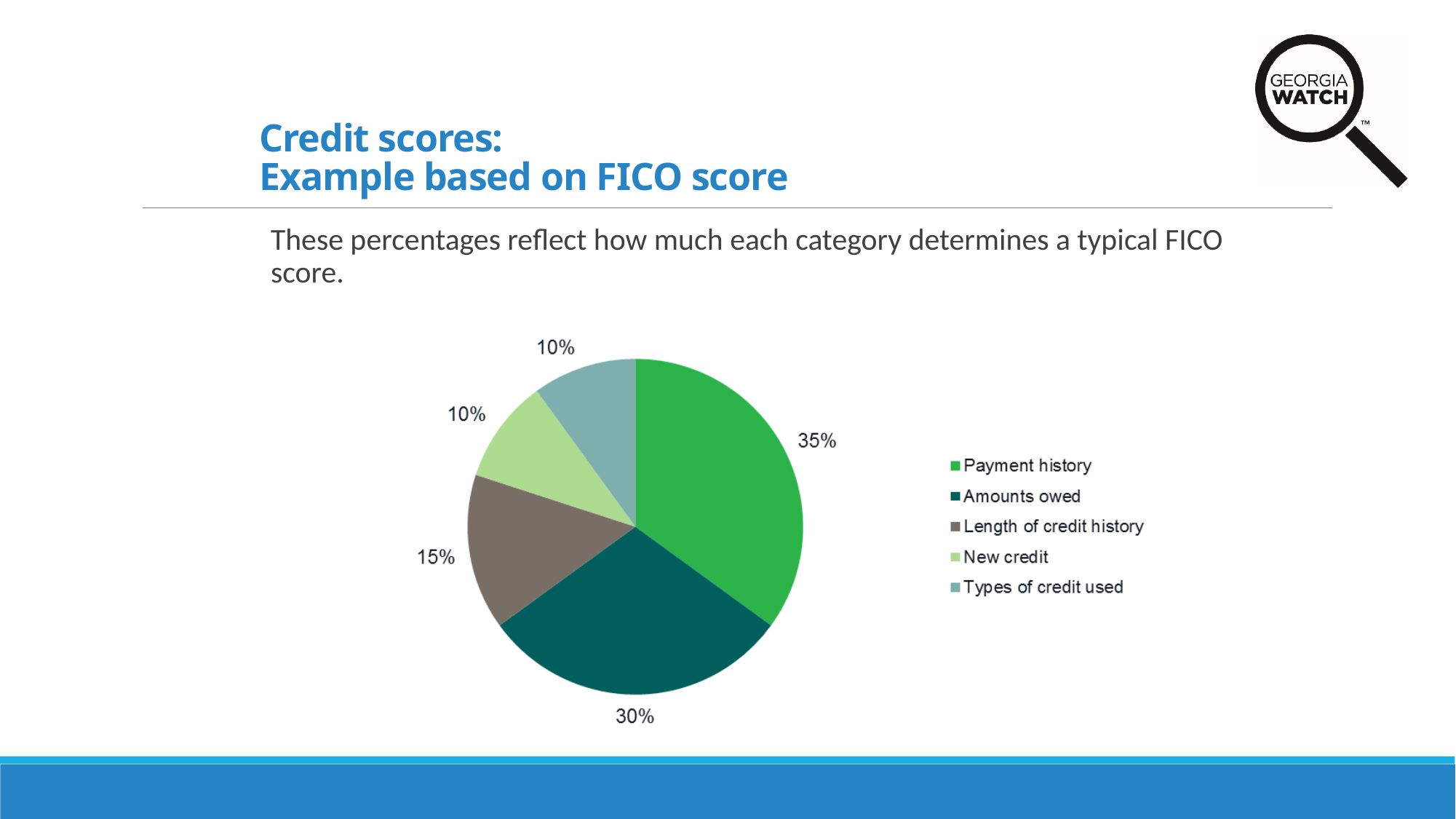
What kind of chart is shown on the slide? Pie chart What percentage of the pie chart is Length of credit history? 15% How many categories does the pie chart show? 5 Which category has the largest share of the pie chart? Payment history What is the difference in percentage points between Payment history and Amounts owed? 5 What percentage of the pie chart is Payment history? 35% What percentage of the pie chart is Types of credit used? 10% What is the difference in percentage points between Amounts owed and Length of credit history? 15 What percentage of the pie chart is New credit? 10% What percentage of the pie chart is Amounts owed? 30% Which is larger, the share for Length of credit history or the share for New credit? Length of credit history What colour is the Amounts owed slice in the pie chart? Dark green